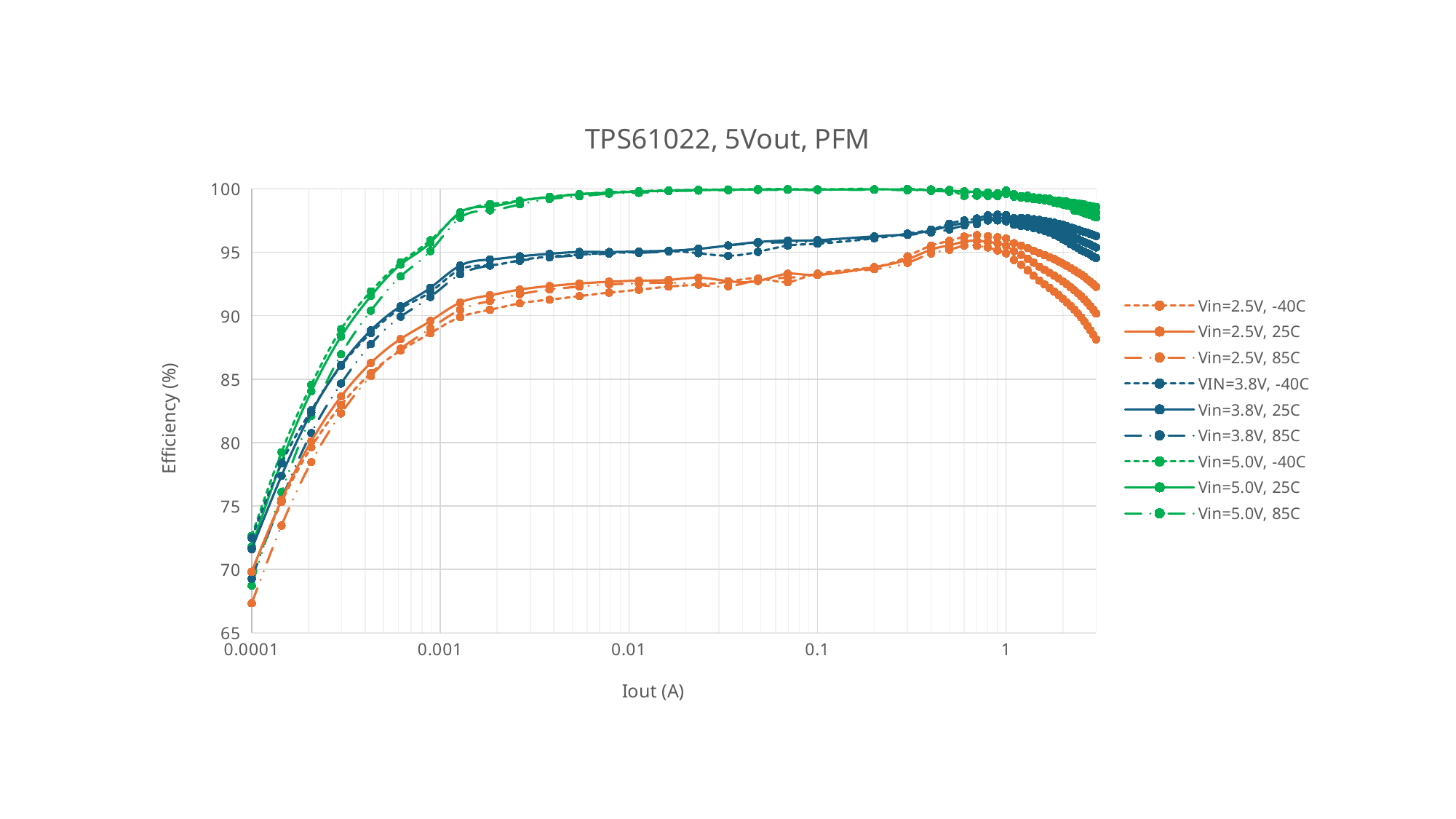
Is the efficiency for Vin=5.0V, 25C at Iout = 0.01 A greater or less than 95? greater At Iout = 0.01 A, which series has the higher efficiency: Vin=5.0V, 25C or Vin=2.5V, 25C? Vin=5.0V, 25C Is the efficiency for Vin=2.5V, 25C at Iout = 0.01 A greater or less than 95? less What kind of chart is shown on the slide? Line chart Is the efficiency for Vin=3.8V, 25C at Iout = 0.1 A greater or less than 95? greater Does the efficiency for Vin=3.8V, 25C rise or fall as Iout increases from 0.0001 A to 0.001 A? rise Which input voltage gives the highest efficiency at Iout = 0.1 A? 5.0V What is the title of the chart? TPS61022, 5Vout, PFM How many series does the legend list? 9 What is the label of the y axis? Efficiency (%)